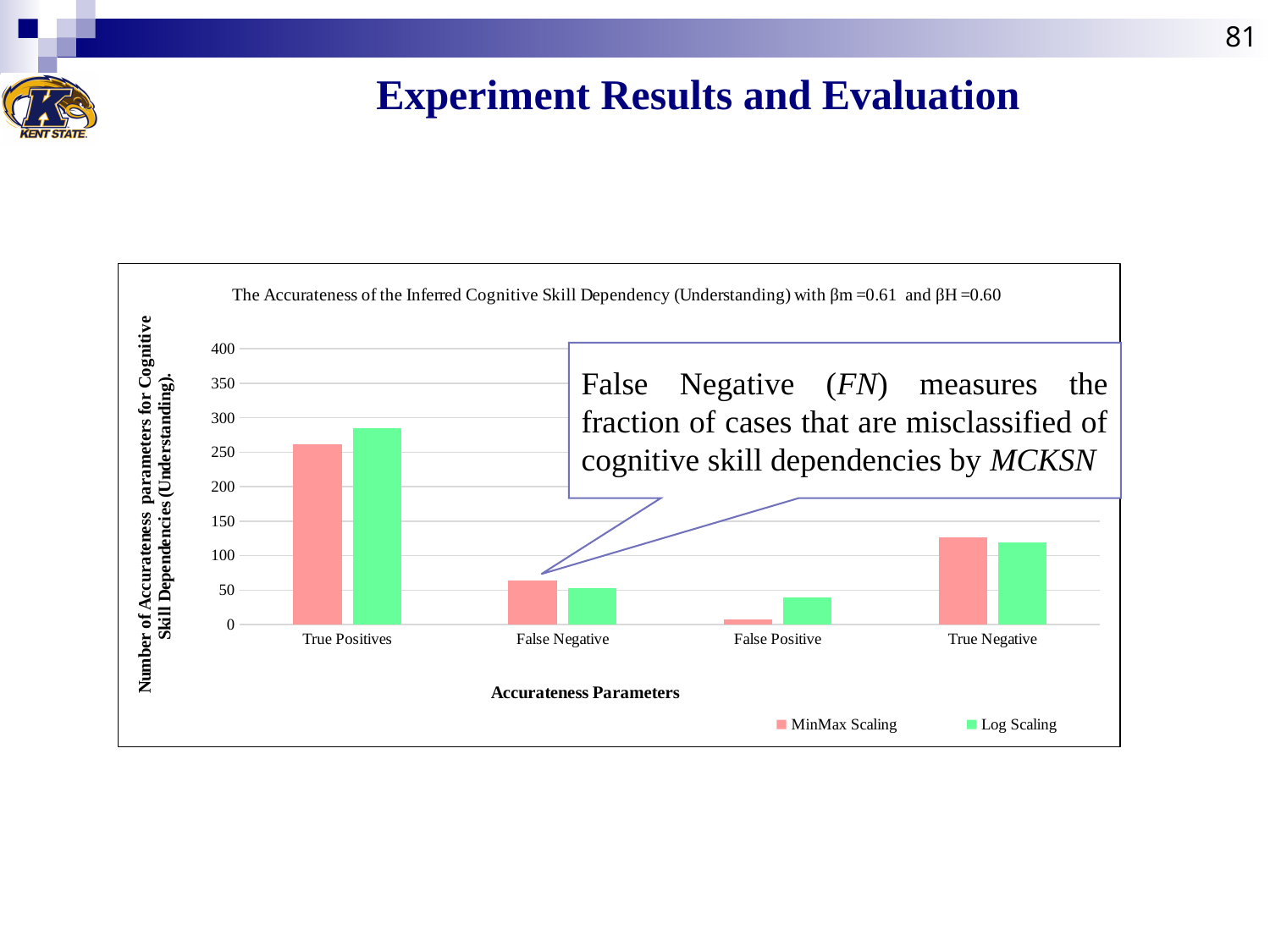
For False Negative, which series has the larger value, MinMax Scaling or Log Scaling? MinMax Scaling How many series does the legend list? 2 Which category has the lowest value for Log Scaling? False Positive For True Positives, which series has the larger value, MinMax Scaling or Log Scaling? Log Scaling Which category has the lowest value for MinMax Scaling? False Positive Which category has the highest value for MinMax Scaling? True Positives How many categories are shown on the x axis? 4 Is the value for False Negative under MinMax Scaling greater or less than 100? less What is the x-axis title of the chart? Accurateness Parameters Is the value for True Negative under MinMax Scaling greater or less than 100? greater Is the value for True Positives under Log Scaling greater or less than 250? greater What kind of chart is shown on the slide? bar chart